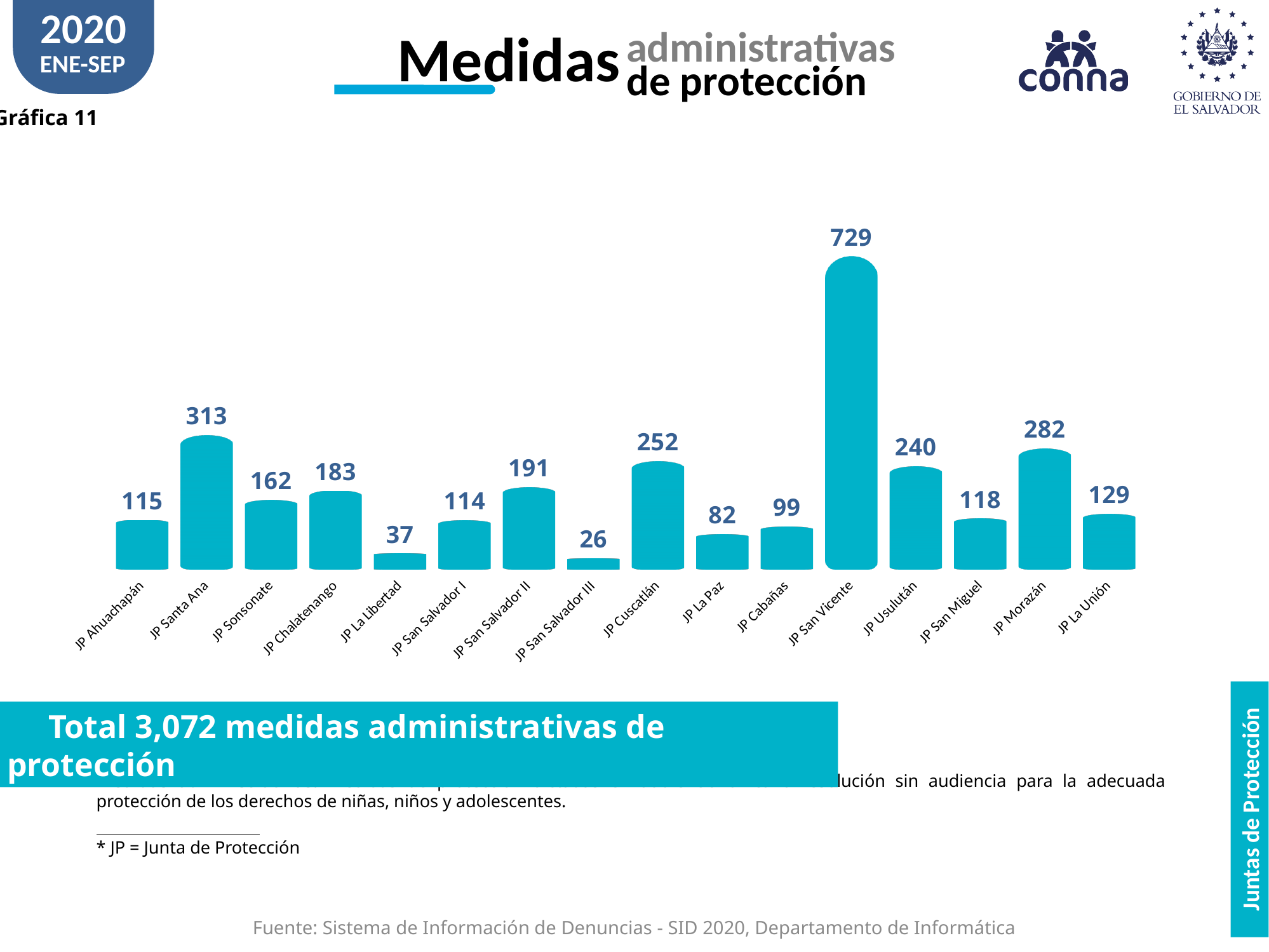
Which category has the highest value? JP San Vicente How many categories are shown on the x axis? 16 What total of administrative protection measures is stated on the slide? 3,072 What is the difference between the values for JP Cuscatlán and JP La Paz? 170 What is the value for JP Santa Ana? 313 What is the value for JP San Vicente? 729 What kind of chart is shown on the slide? bar chart Which category has the lowest value? JP San Salvador III What is the value for JP Cabañas? 99 Which is larger, the value for JP Morazán or the value for JP Usulután? JP Morazán What is the value for JP La Libertad? 37 What is the difference between the values for JP San Vicente and JP Santa Ana? 416